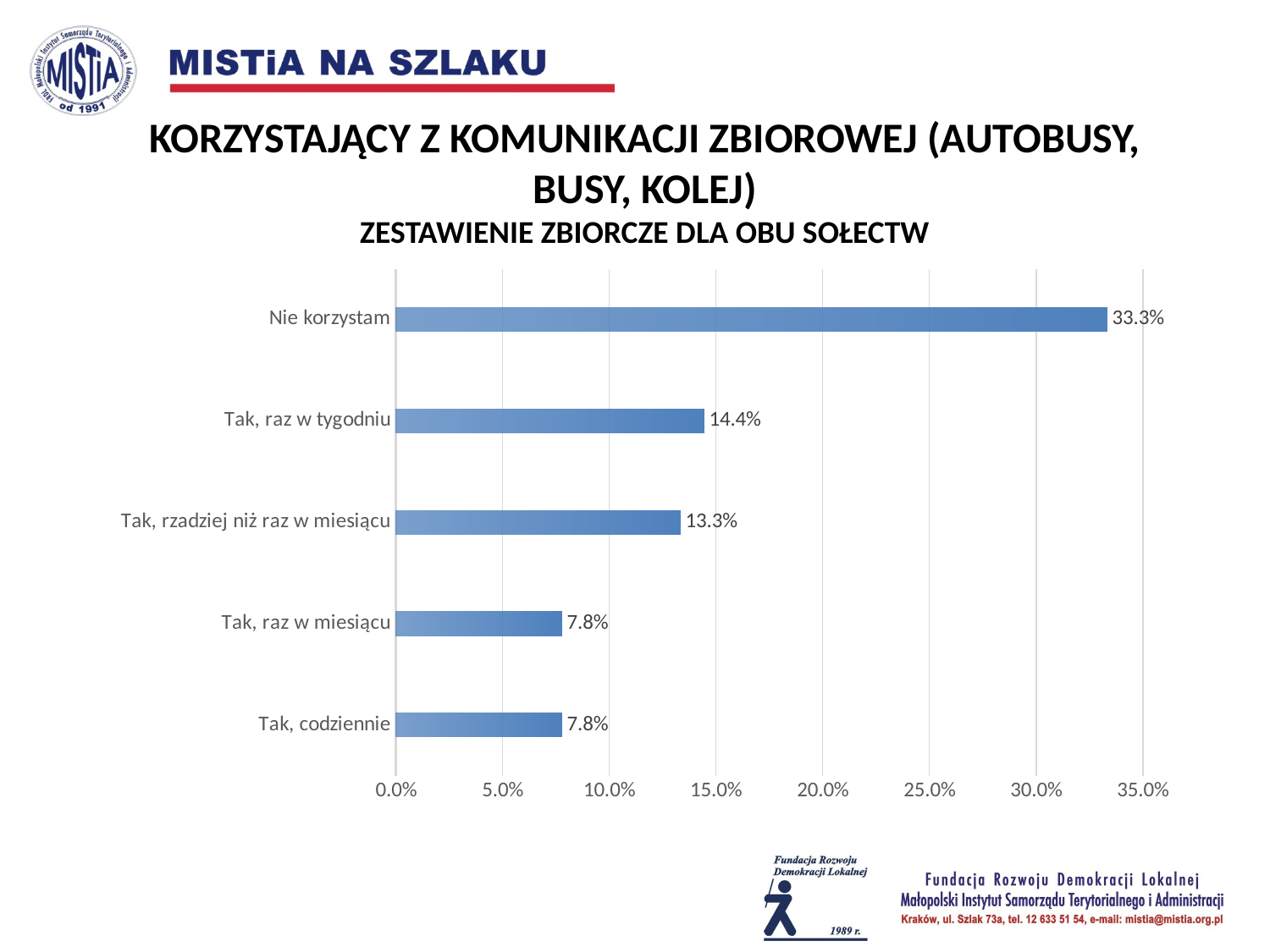
What is the value for "Tak, rzadziej niż raz w miesiącu"? 13.3% What kind of chart is shown on the slide? bar chart How many categories are shown in the chart? 5 What is the value for "Nie korzystam"? 33.3% What is the value for "Tak, codziennie"? 7.8% What is the value for "Tak, raz w tygodniu"? 14.4% Is the value for "Nie korzystam" greater or less than 30.0%? greater What is the difference between "Tak, raz w tygodniu" and "Tak, rzadziej niż raz w miesiącu"? 1.1% Which category has the highest value? Nie korzystam What is the maximum value shown on the x axis? 35.0% Which is larger, the value for "Tak, raz w tygodniu" or the value for "Tak, raz w miesiącu"? Tak, raz w tygodniu What is the difference between "Nie korzystam" and "Tak, raz w tygodniu"? 18.9%